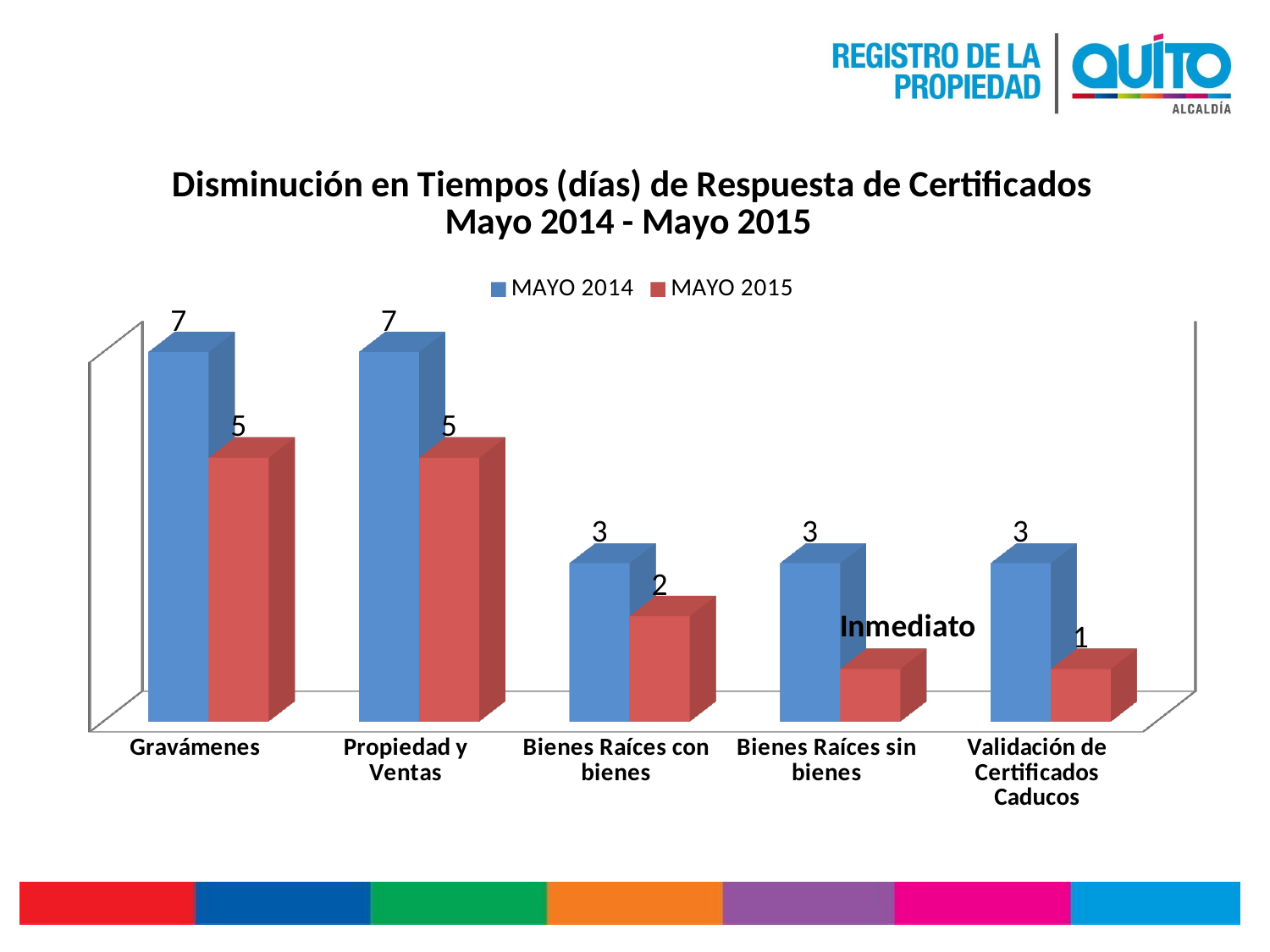
How many categories are shown on the x axis? 5 What is the MAYO 2015 value shown for Bienes Raíces sin bienes? Inmediato What kind of chart is shown on the slide? Bar chart What is the difference between the MAYO 2014 and MAYO 2015 values for Gravámenes? 2 What is the difference between the MAYO 2014 and MAYO 2015 values for Bienes Raíces con bienes? 1 Which is larger: the MAYO 2014 value for Propiedad y Ventas or the MAYO 2014 value for Validación de Certificados Caducos? Propiedad y Ventas What is the MAYO 2015 value for Validación de Certificados Caducos? 1 What is the MAYO 2014 value for Gravámenes? 7 How many series does the legend list? 2 Which colour represents MAYO 2015 in the legend? Red What is the MAYO 2015 value for Bienes Raíces con bienes? 2